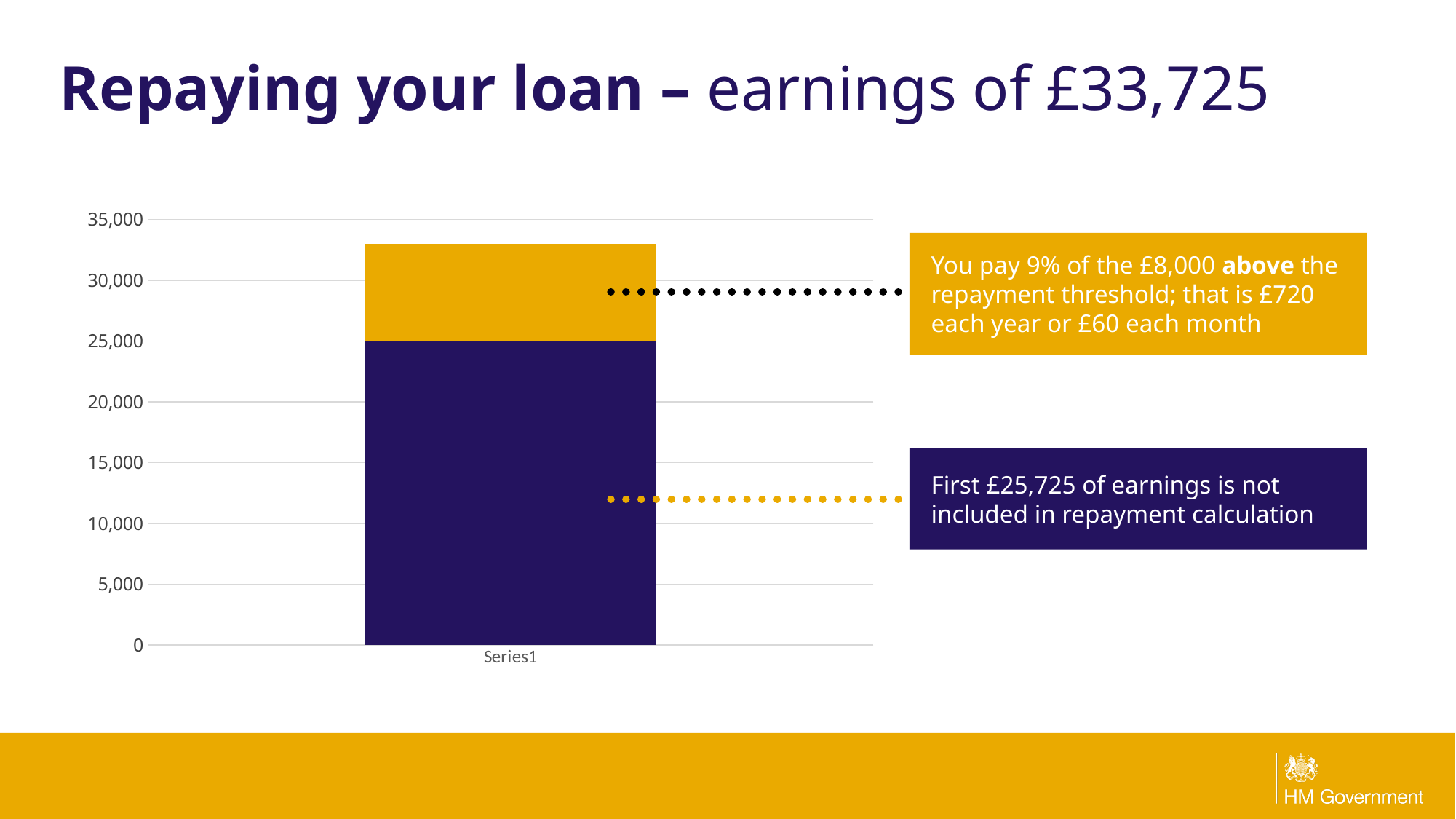
How many bars (categories) are plotted in the chart? 1 Is the top of the dark purple (bottom) segment of the bar greater or less than 20,000? greater Is the total height of the stacked bar greater or less than 35,000? less Which segment of the bar is larger, the dark purple segment or the gold segment? the dark purple segment What kind of chart is shown on the slide? bar chart Is the total height of the stacked bar greater or less than 30,000? greater What is the category label shown on the x axis of the chart? Series1 According to the annotation pointing to the dark purple segment, how much of the earnings is not included in the repayment calculation? £25,725